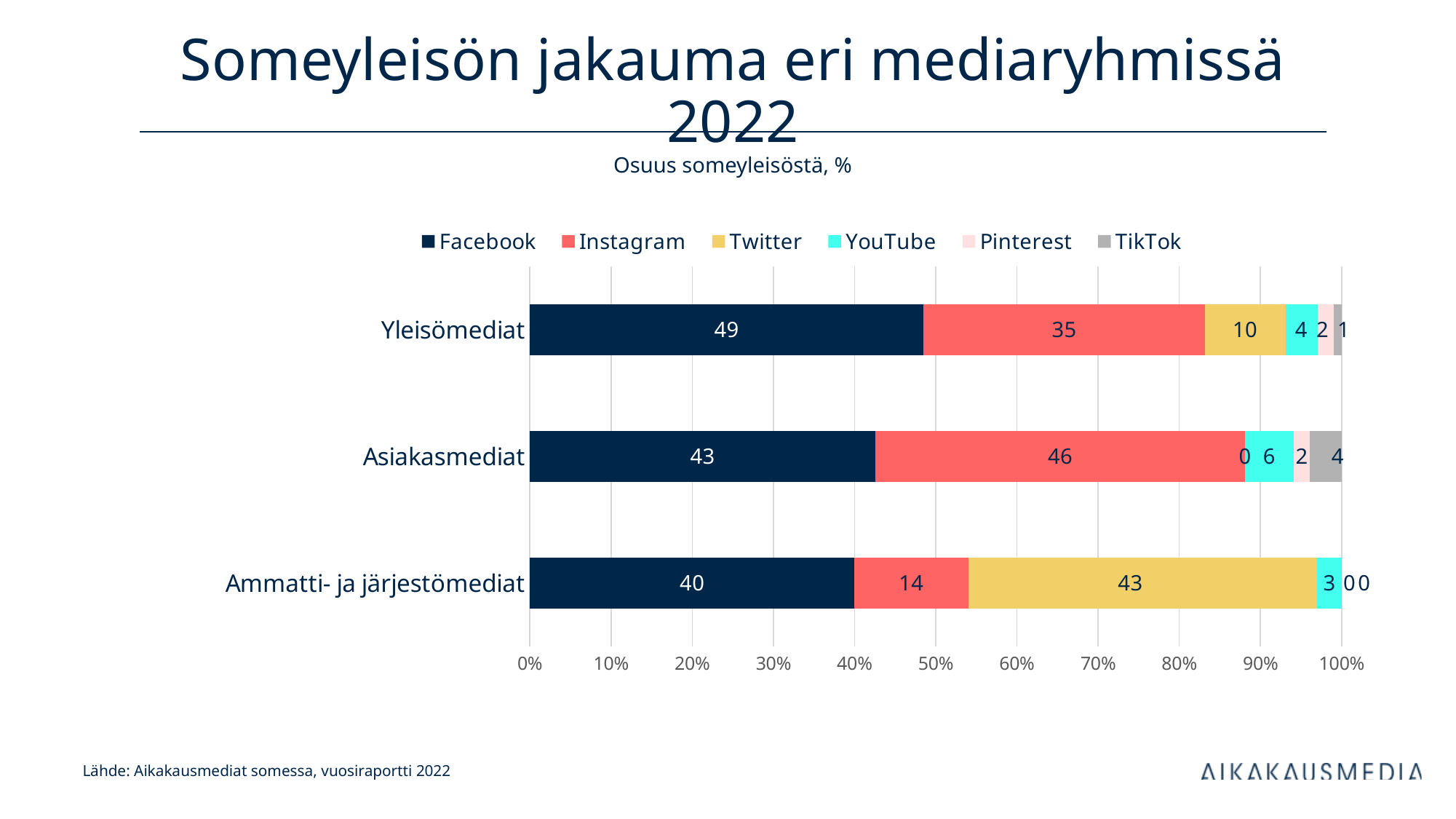
Which is larger for Ammatti- ja järjestömediat: the Facebook value or the Twitter value? Twitter What is the Facebook value for Yleisömediat? 49 What is the TikTok value for Asiakasmediat? 4 How many series does the legend list? 6 Which media group has the highest Facebook value? Yleisömediat Which media group has the lowest Instagram value? Ammatti- ja järjestömediat What is the difference between the Instagram values for Asiakasmediat and Yleisömediat? 11 What is the Twitter value for Ammatti- ja järjestömediat? 43 What kind of chart is shown on the slide? Stacked bar chart What is the Instagram value for Asiakasmediat? 46 How many media groups are shown on the chart? 3 What is the subtitle shown above the chart? Osuus someyleisöstä, %